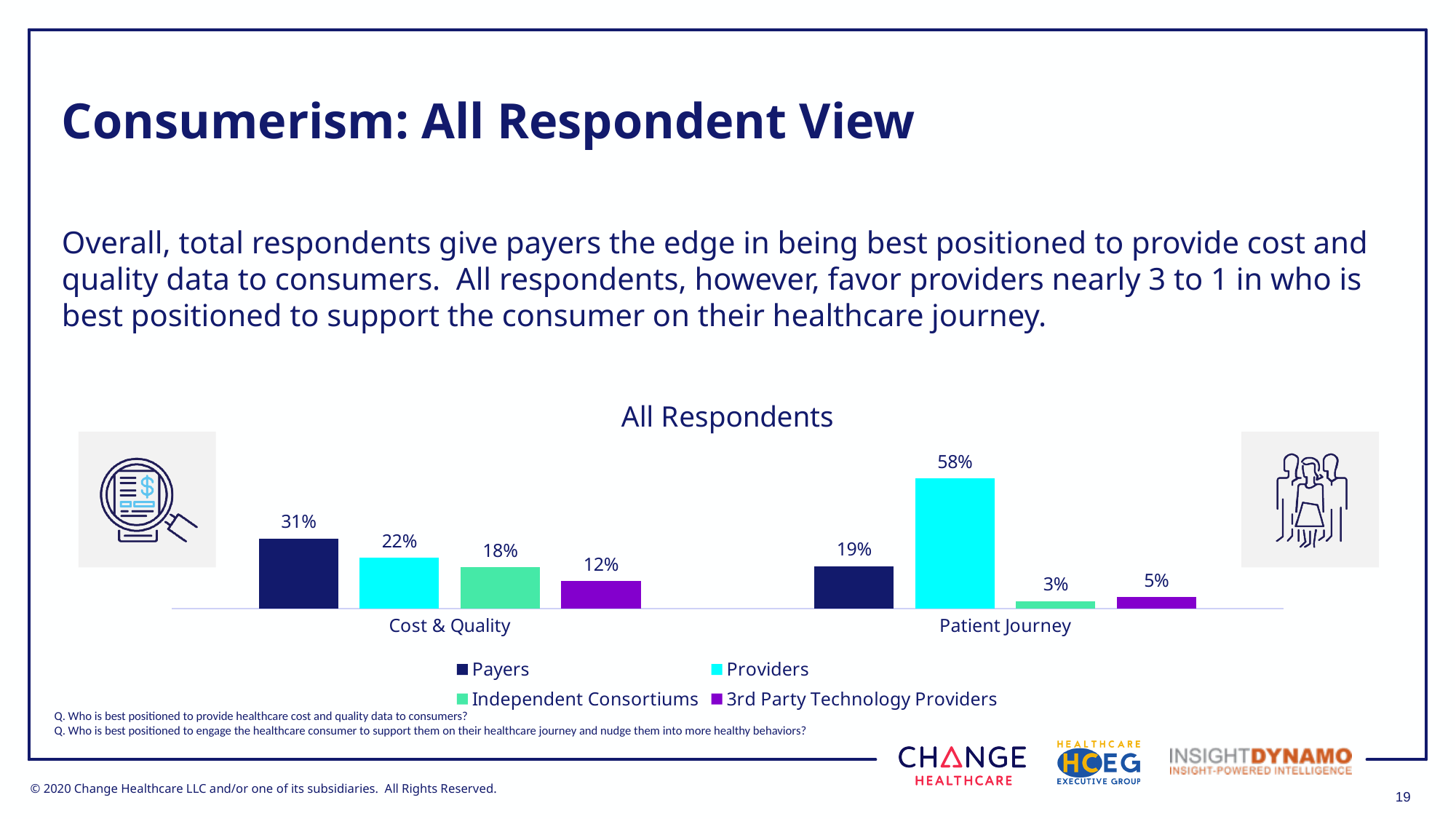
What is the value for Payers in the Cost & Quality category? 31% What is the value for Providers in the Patient Journey category? 58% What is the value for 3rd Party Technology Providers in the Cost & Quality category? 12% How many categories are shown on the x axis? 2 What is the difference between the Providers value and the Payers value in the Patient Journey category? 39% What is the value for Independent Consortiums in the Patient Journey category? 3% Which is larger in the Cost & Quality category: Providers or Independent Consortiums? Providers Which series has the highest value in the Cost & Quality category? Payers How many series does the legend list? 4 What kind of chart is shown on the slide? Bar chart What is the title of the chart? All Respondents Which series has the lowest value in the Patient Journey category? Independent Consortiums